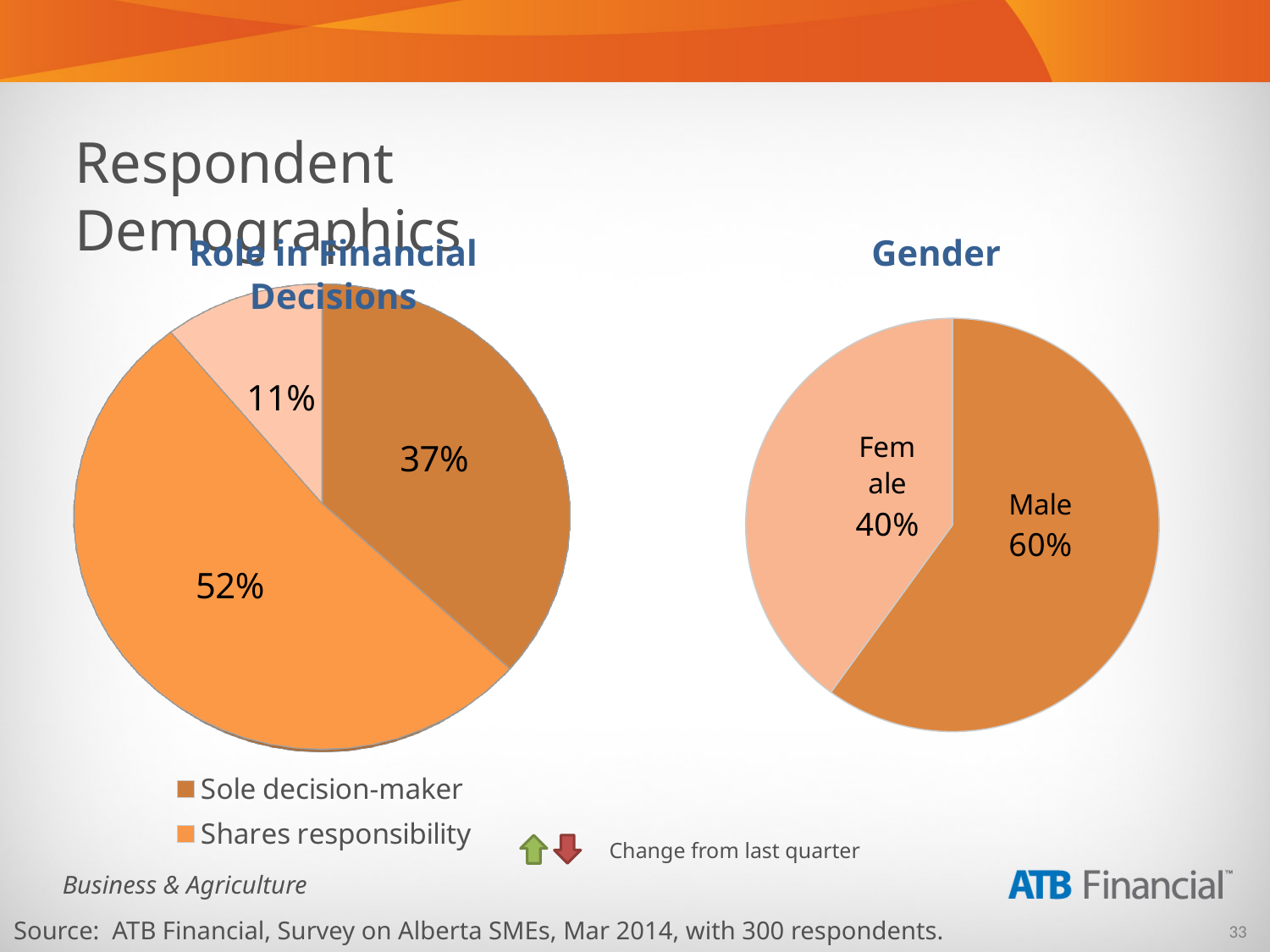
How many slices does the Role in Financial Decisions pie chart have? 3 In the Role in Financial Decisions chart, what is the smallest percentage shown? 11% In the Role in Financial Decisions chart, what percentage of respondents are sole decision-makers? 37% In the Role in Financial Decisions chart, what is the difference in percentage points between Shares responsibility and Sole decision-maker? 15 In the Gender chart, which category has the larger share? Male In the Gender chart, what is the difference in percentage points between Male and Female? 20 In the Role in Financial Decisions chart, what percentage of respondents share responsibility? 52% In the Role in Financial Decisions chart, which category has the largest share? Shares responsibility In the Role in Financial Decisions chart, which is larger: Sole decision-maker or Shares responsibility? Shares responsibility In the Gender chart, what percentage of respondents are male? 60% What kind of chart is the Gender chart? Pie chart In the Gender chart, what percentage of respondents are female? 40%